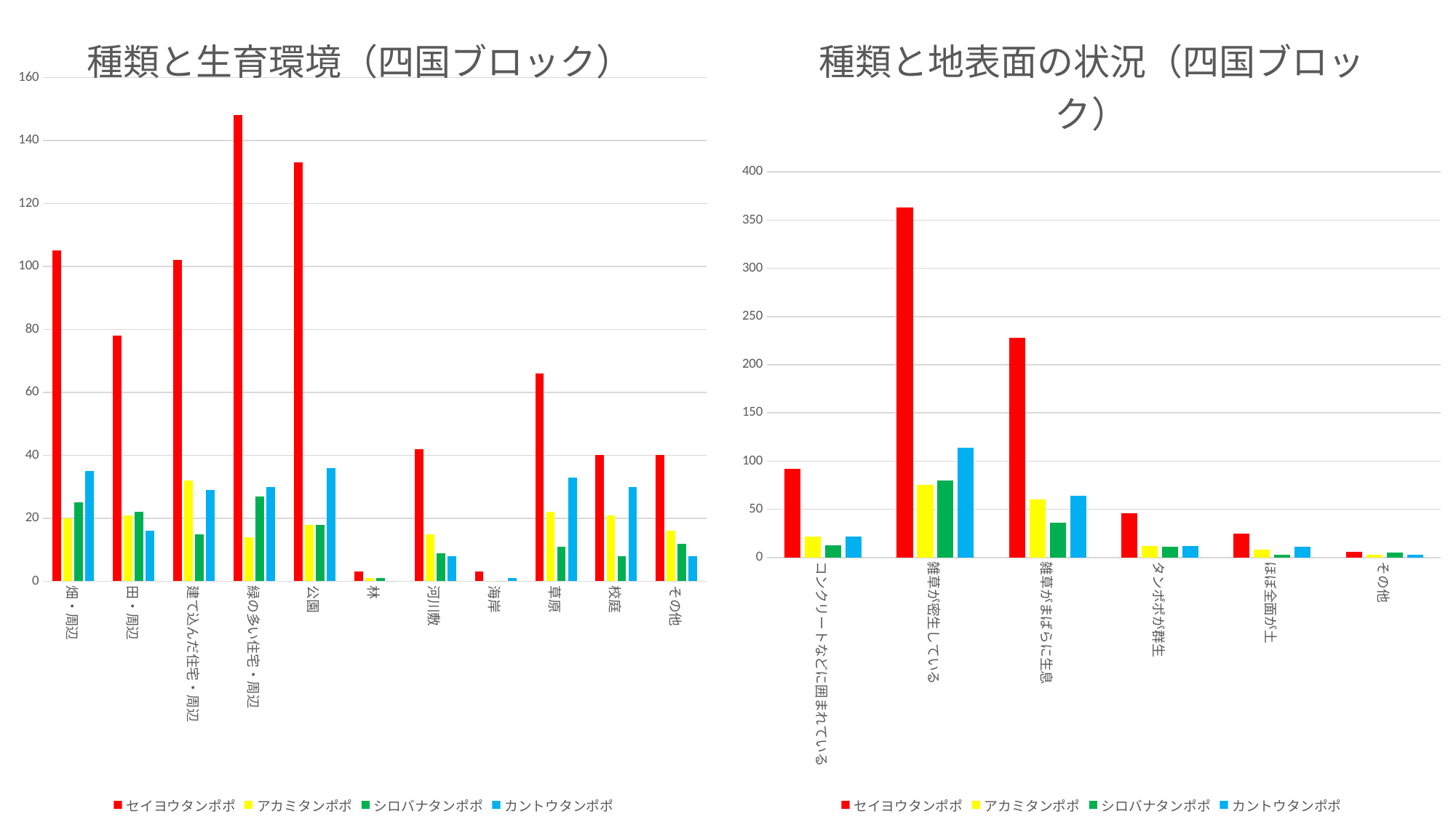
Which series is shown in red in the legend of the left chart (種類と生育環境)? セイヨウタンポポ In the right chart (種類と地表面の状況), is the value for カントウタンポポ at 雑草が密生している greater or less than 100? greater How many categories are shown on the x axis of the left chart (種類と生育環境)? 11 In the right chart (種類と地表面の状況), which category has the lowest value for セイヨウタンポポ? その他 In the left chart (種類と生育環境), which category has the highest value for セイヨウタンポポ? 緑の多い住宅・周辺 What kind of chart is the left chart titled 種類と生育環境（四国ブロック）? bar chart How many categories are shown on the x axis of the right chart (種類と地表面の状況)? 6 How many series does the legend of the right chart (種類と地表面の状況) list? 4 In the left chart (種類と生育環境), which is larger for セイヨウタンポポ: 公園 or 草原? 公園 In the left chart (種類と生育環境), is the value for セイヨウタンポポ at 畑・周辺 greater or less than 100? greater In the right chart (種類と地表面の状況), which category has the highest value for セイヨウタンポポ? 雑草が密生している In the right chart (種類と地表面の状況), is the value for セイヨウタンポポ at 雑草がまばらに生息 greater or less than 200? greater